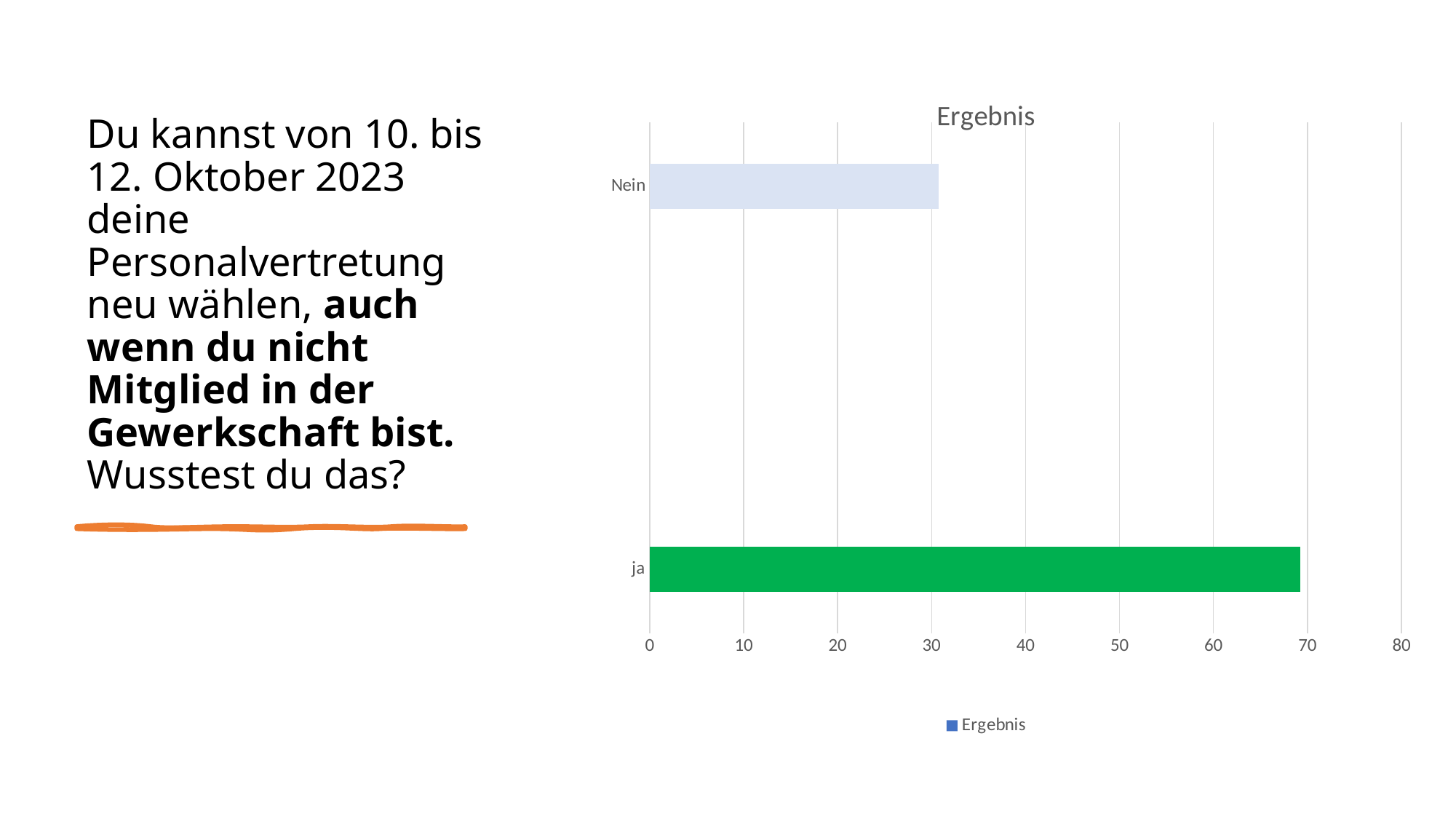
Is the value for ja greater or less than 60? greater Is the value for Nein greater or less than 40? less Is the value for ja greater or less than 80? less Which category has the lowest value? Nein Which is larger, the value for ja or the value for Nein? ja What is the title of the chart? Ergebnis How many series does the legend list? 1 How many categories are shown in the chart? 2 Which category has the highest value? ja What is the name of the series listed in the legend? Ergebnis What type of chart is shown on the slide? bar chart